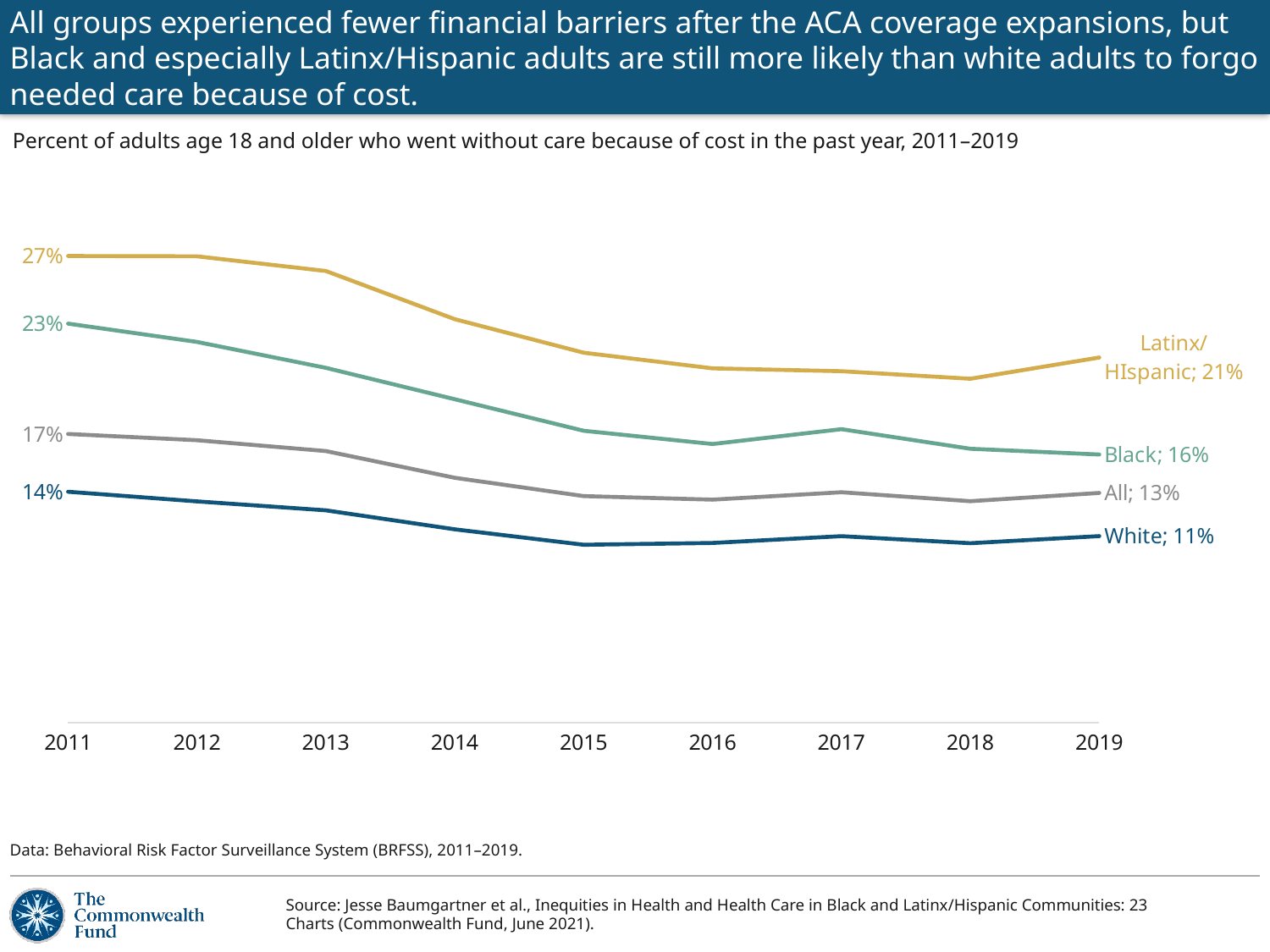
Did the value for Black adults rise or fall from 2011 to 2019? fall Which group had the highest percentage in 2019? Latinx/Hispanic What is the difference between the Latinx/Hispanic value and the White value in 2019? 10 percentage points Which is larger in 2011: the value for Black adults or the value for All adults? Black What was the value for White adults in 2011? 14% How many series (groups) are plotted on the chart? 4 What was the value for All adults in 2019? 13% How many years are shown along the x axis? 9 What was the value for Black adults in 2019? 16% What type of chart is shown on the slide? line chart Which group had the lowest percentage in 2011? White What was the value for Latinx/Hispanic adults in 2011? 27%